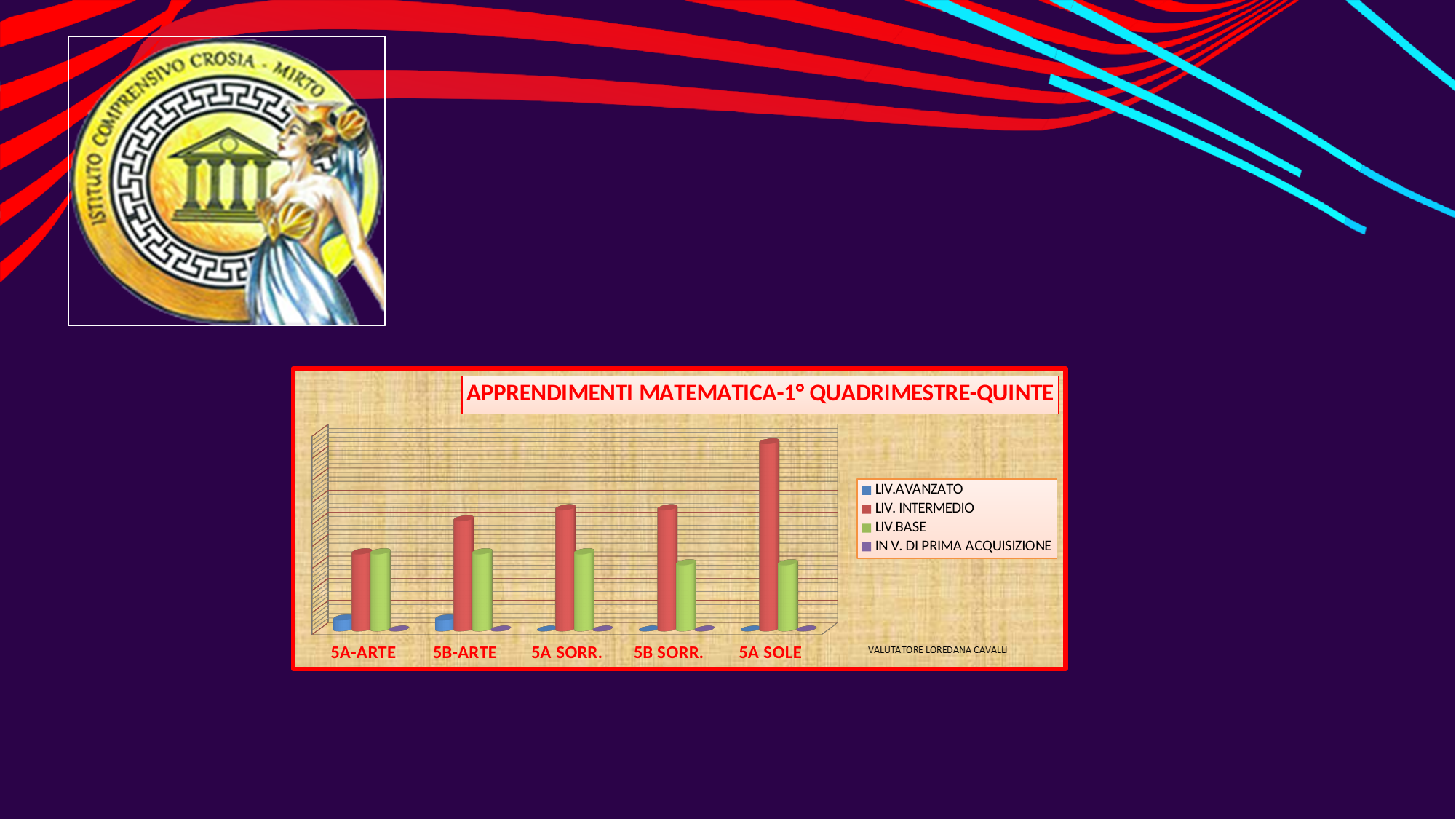
For 5B-ARTE, which is larger: LIV. INTERMEDIO or LIV.BASE? LIV. INTERMEDIO Which class has the highest LIV. INTERMEDIO bar? 5A SOLE For 5A SOLE, which is larger: LIV. INTERMEDIO or LIV.BASE? LIV. INTERMEDIO What kind of chart is shown on the slide? bar chart How many classes (categories) are shown on the x axis of the chart? 5 What is the title of the chart? APPRENDIMENTI MATEMATICA-1° QUADRIMESTRE-QUINTE Which class has the lowest LIV. INTERMEDIO bar? 5A-ARTE Do the LIV. INTERMEDIO values generally rise or fall from 5A-ARTE to 5A SOLE? rise How many series does the chart's legend list? 4 Which series is shown in green in the chart's legend? LIV.BASE